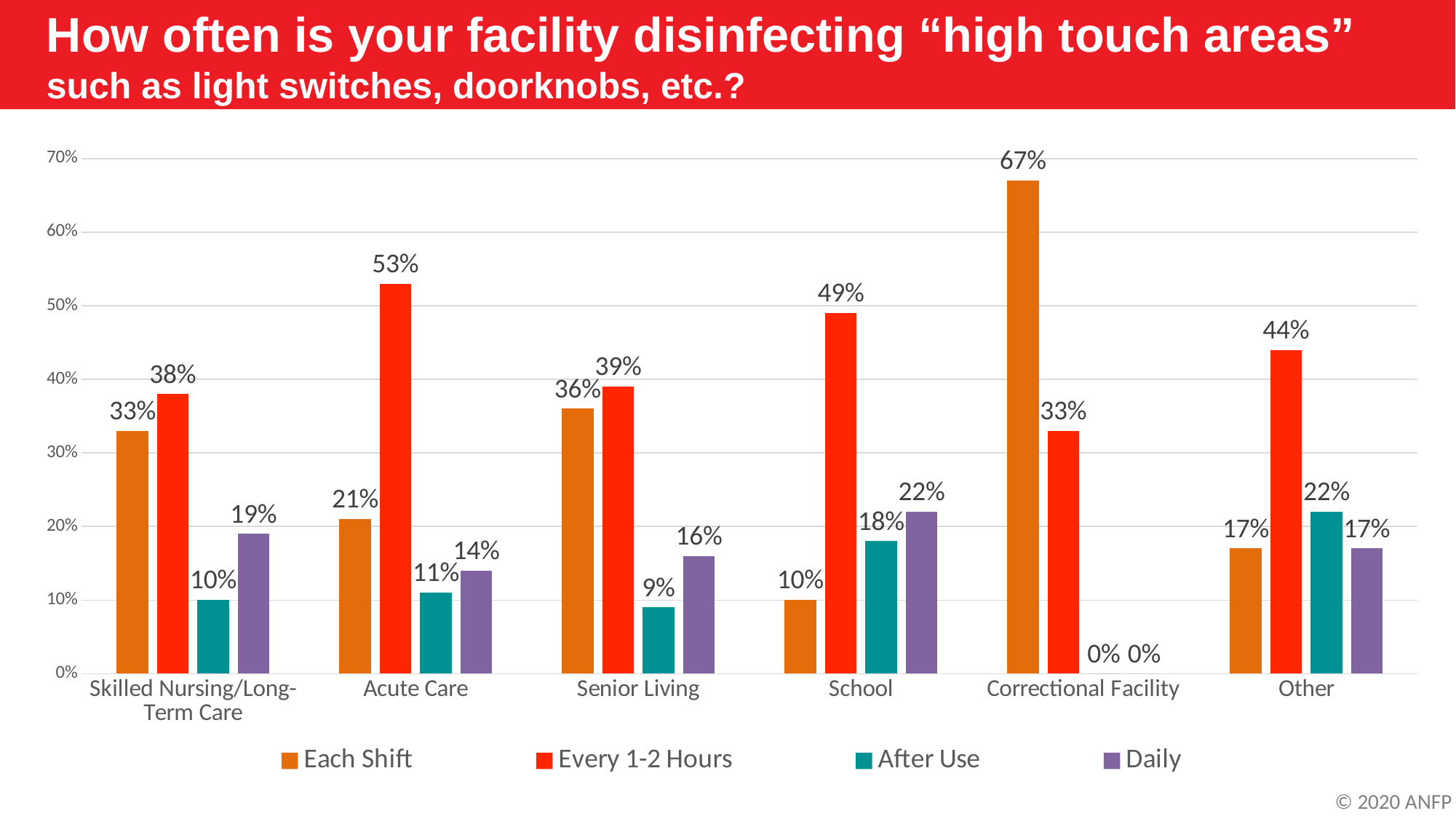
What kind of chart is shown on the slide? Bar chart Which colour represents the After Use series in the legend? Teal Is the Each Shift value for Correctional Facility greater or less than 60%? greater What is the value for After Use in the Senior Living category? 9% How many facility type categories are shown on the x axis? 6 What is the difference between the Every 1-2 Hours and Each Shift values for Acute Care? 32% Which facility type has the lowest value for Every 1-2 Hours? Correctional Facility How many series does the legend list? 4 What percentage of Acute Care facilities disinfect high touch areas every 1-2 hours? 53% Which is larger for Other: Every 1-2 Hours or After Use? Every 1-2 Hours Which facility type has the highest value for Each Shift? Correctional Facility What is the value for Daily in the School category? 22%